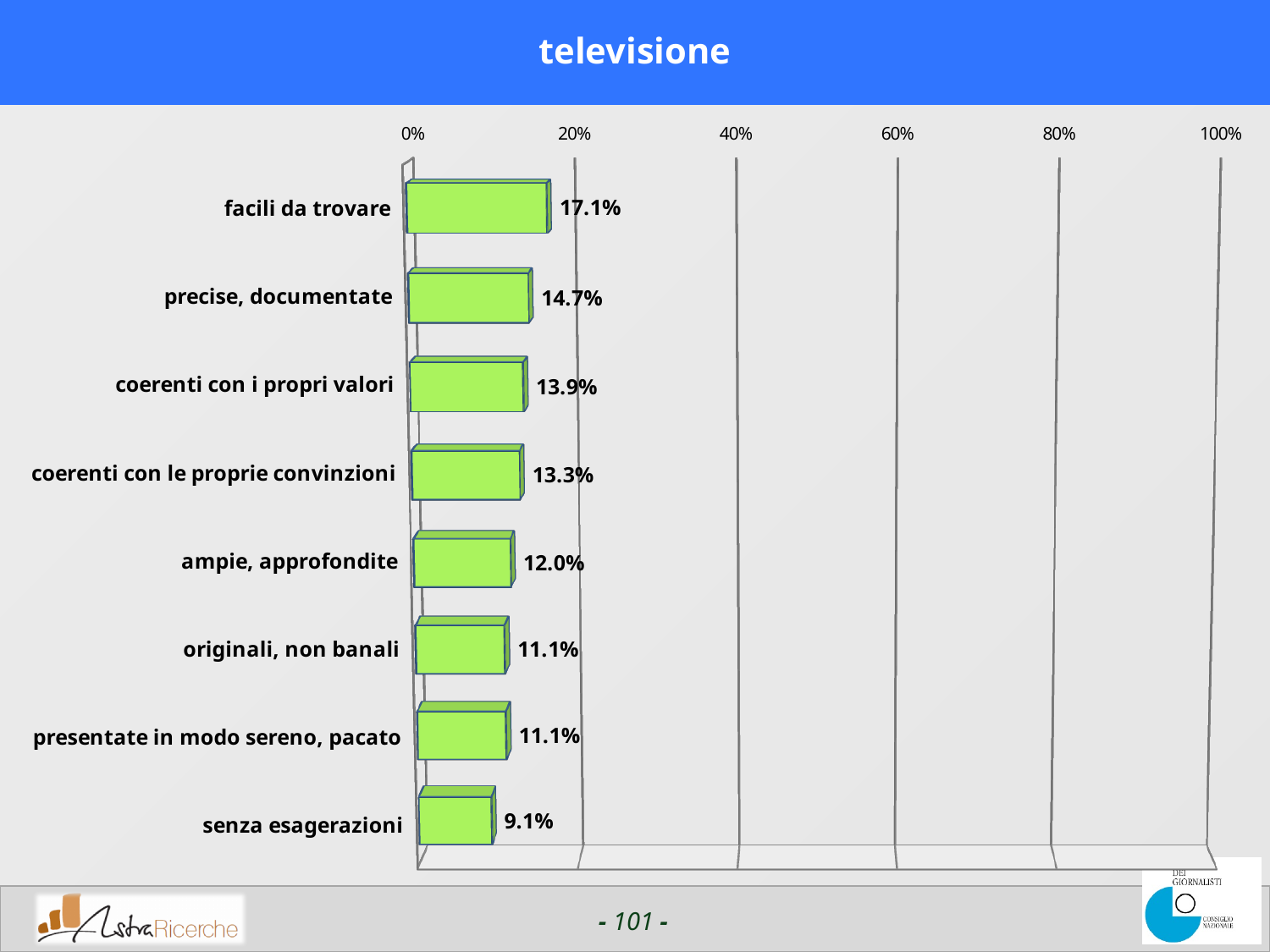
What is the value for "senza esagerazioni"? 9.1% Which category has the lowest value? senza esagerazioni Which category has the highest value? facili da trovare What is the value for "precise, documentate"? 14.7% What is the value for "facili da trovare"? 17.1% Is the value for "facili da trovare" greater or less than 20%? less Which is larger: "coerenti con le proprie convinzioni" or "ampie, approfondite"? coerenti con le proprie convinzioni What type of chart is shown on the slide? bar chart What is the difference between "facili da trovare" and "senza esagerazioni"? 8.0% How many categories are shown in the chart? 8 What is the value for "ampie, approfondite"? 12.0% What is the difference between "precise, documentate" and "coerenti con i propri valori"? 0.8%